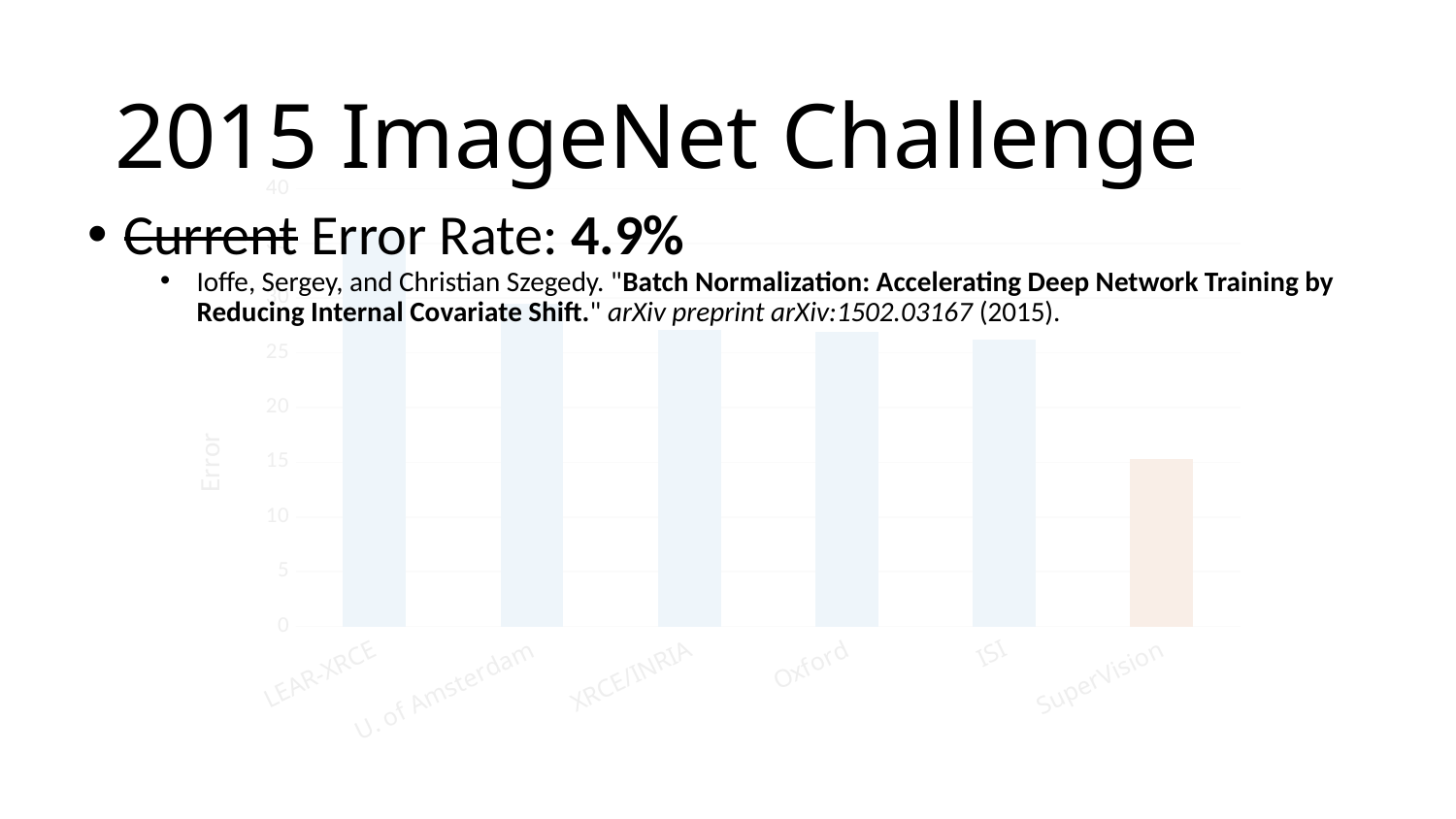
Which team has the lowest error on the chart? SuperVision Which has the larger error, U. of Amsterdam or ISI? U. of Amsterdam Which team's bar is shown in a different colour from the others? SuperVision Which team has the highest error on the chart? LEAR-XRCE How many categories (teams) are plotted on the chart? 6 Is the value for LEAR-XRCE greater or less than 25? greater Is the value for SuperVision greater or less than 20? less What is the label on the vertical axis of the chart? Error Do the error values rise or fall moving from left to right across the chart? fall Is the value for ISI greater or less than 20? greater What kind of chart is shown on the slide? bar chart Which has the larger error, LEAR-XRCE or SuperVision? LEAR-XRCE